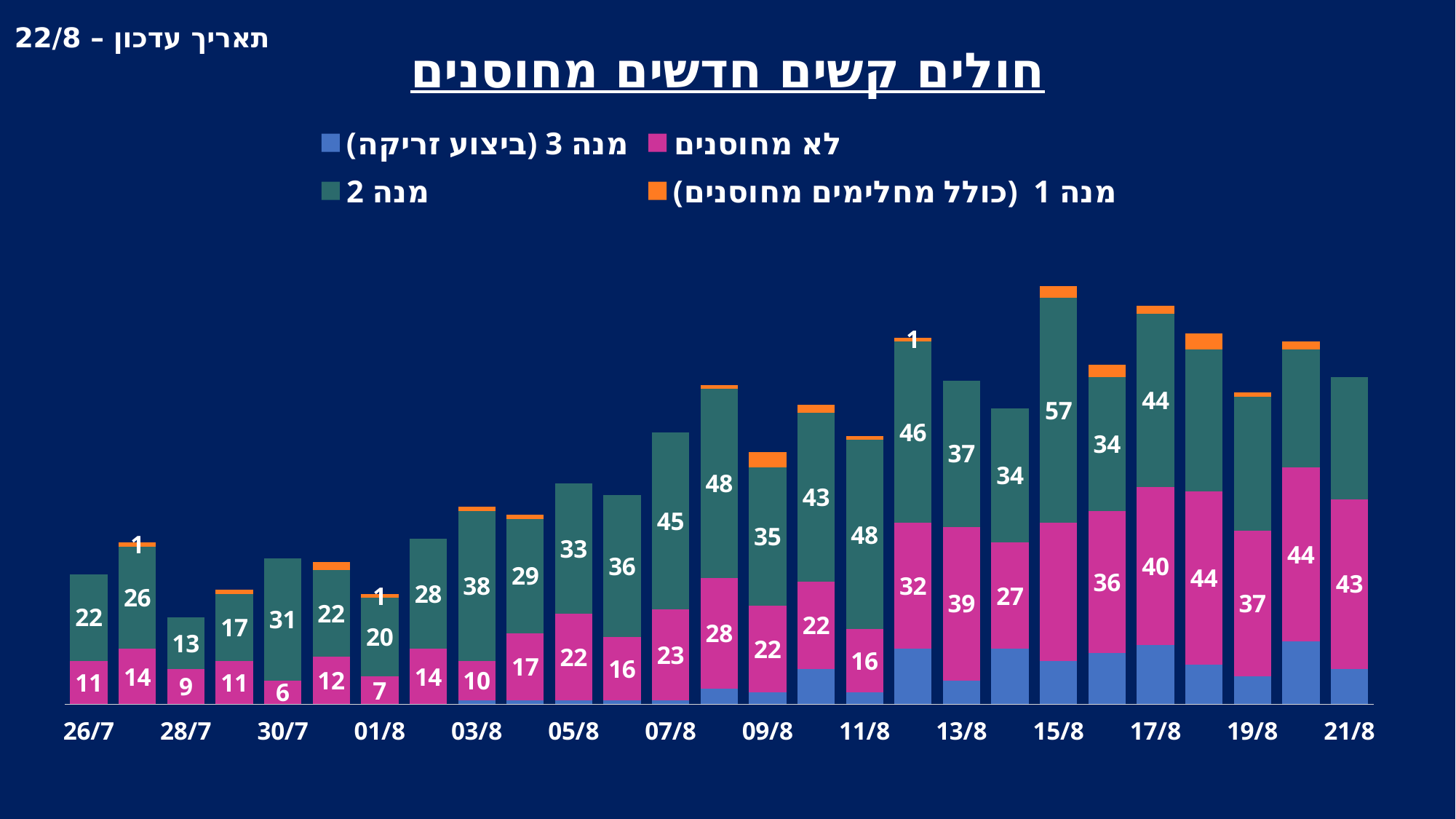
How many series does the legend list? 4 What type of chart is shown on the slide? Stacked bar chart What is the value of the מנה 2 segment for 03/8? 38 On which date is the מנה 2 segment the largest? 15/8 Which is larger on 13/8: the לא מחוסנים segment or the מנה 2 segment? לא מחוסנים What is the value of the לא מחוסנים segment for 26/7? 11 Do the bar heights generally rise or fall from 26/7 to 21/8? Rise What is the difference between the מנה 2 values for 08/8 and 07/8? 3 What is the value of the מנה 2 segment for 15/8? 57 How many dates (bars) are shown on the x axis? 27 On which date is the לא מחוסנים segment the smallest? 30/7 What colour represents the לא מחוסנים series in the legend? Magenta (pink)